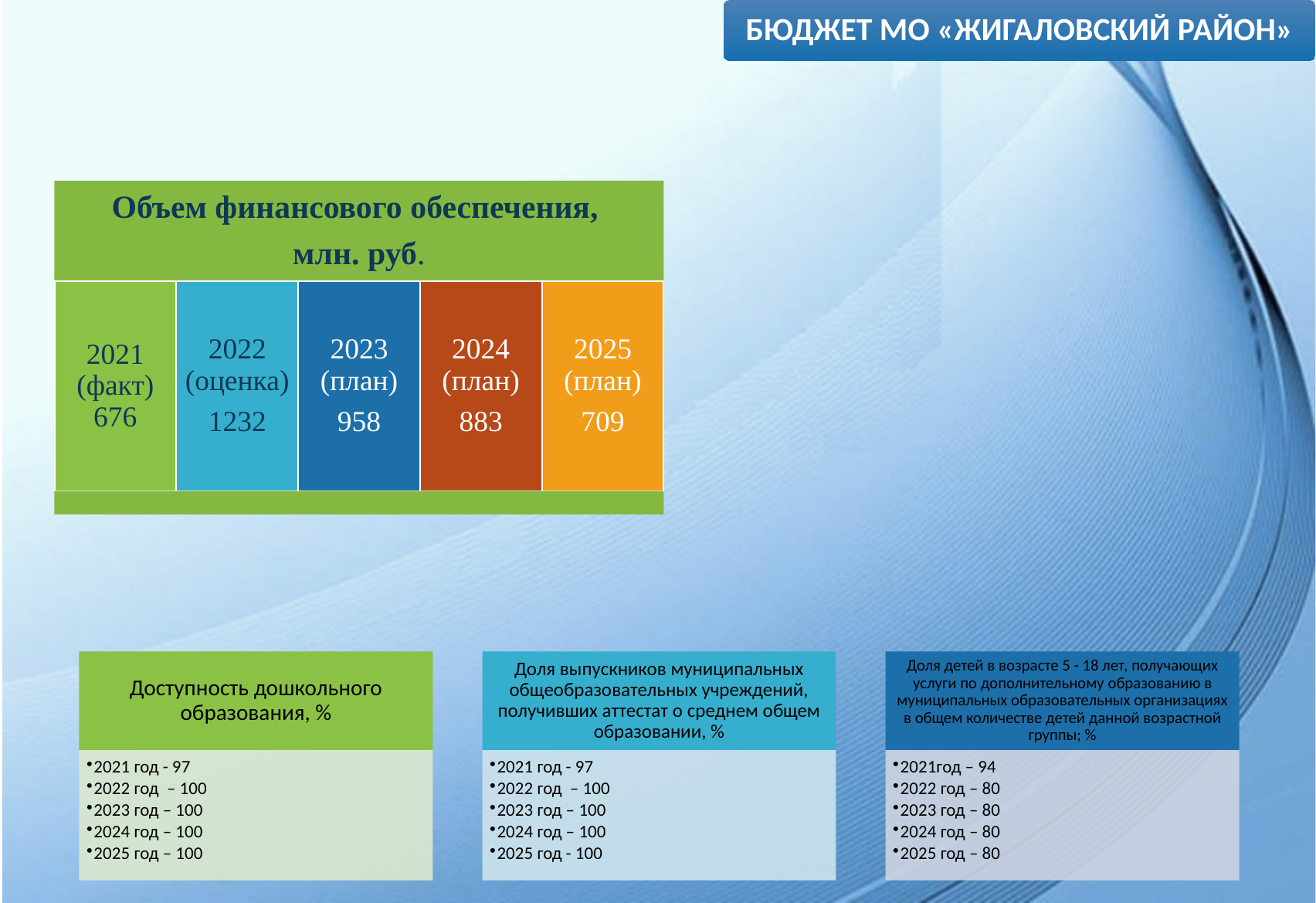
In the block 'Объем финансового обеспечения, млн. руб.', what is the value for 2023 (план)? 958 In the block 'Объем финансового обеспечения, млн. руб.', what is the value for 2021 (факт)? 676 In the block 'Объем финансового обеспечения, млн. руб.', what is the value for 2025 (план)? 709 In the block 'Объем финансового обеспечения, млн. руб.', which year has the lowest value? 2021 (факт) In the block 'Объем финансового обеспечения, млн. руб.', what is the value for 2022 (оценка)? 1232 In the block 'Объем финансового обеспечения, млн. руб.', which year has the highest value? 2022 (оценка) How many years are shown in the block 'Объем финансового обеспечения, млн. руб.'? 5 In the block 'Объем финансового обеспечения, млн. руб.', what is the difference between the 2023 (план) value and the 2024 (план) value? 75 In the block 'Объем финансового обеспечения, млн. руб.', do the values rise or fall from 2022 to 2025? fall In the block 'Объем финансового обеспечения, млн. руб.', what is the difference between the 2022 (оценка) value and the 2021 (факт) value? 556 What unit is stated in the title of the block 'Объем финансового обеспечения'? млн. руб. In the block 'Объем финансового обеспечения, млн. руб.', which is larger: the value for 2024 (план) or the value for 2025 (план)? 2024 (план)